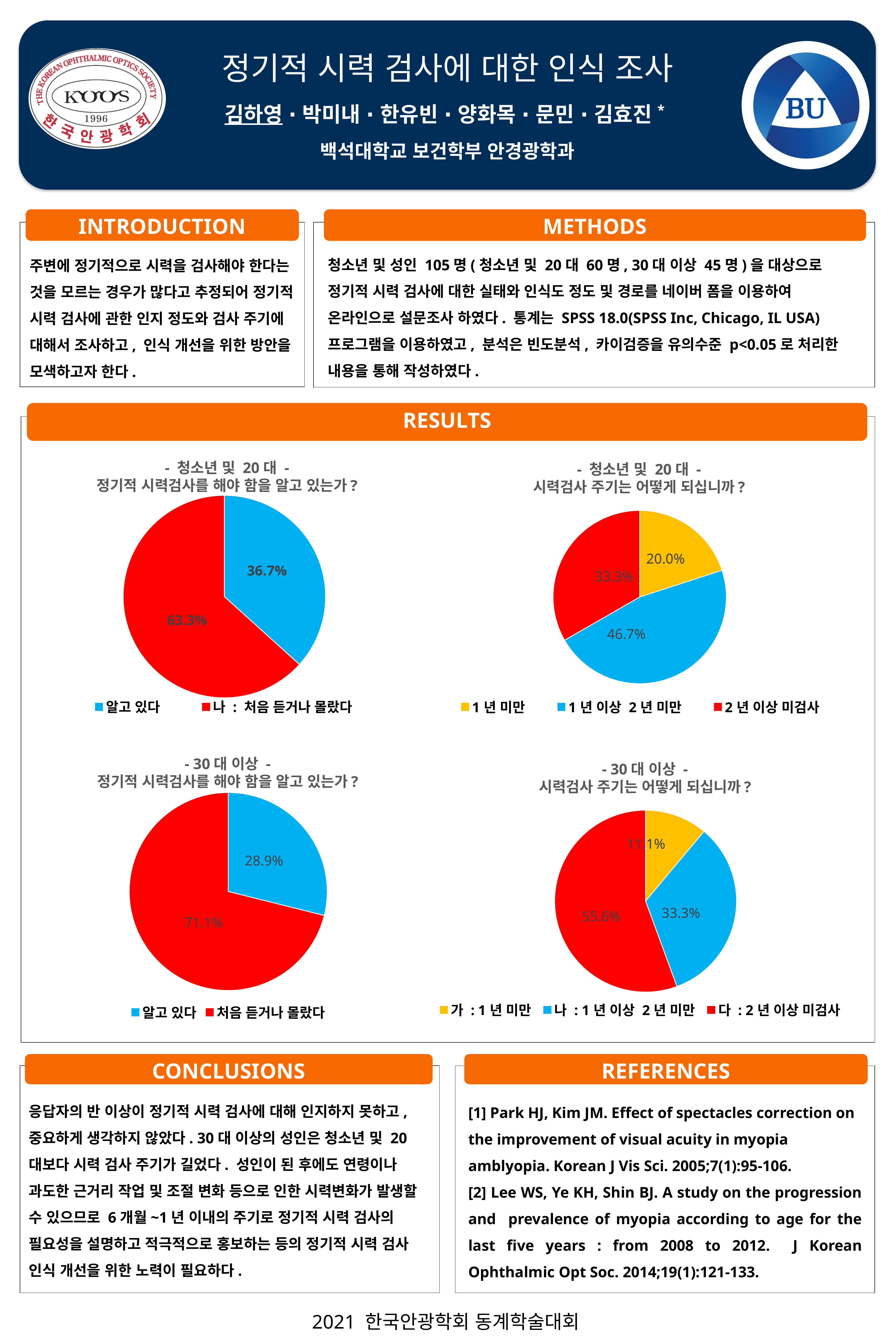
In the bottom-left pie chart (30대 이상, 정기적 시력검사를 해야 함을 알고 있는가?), what is the difference between 처음 듣거나 몰랐다 and 알고 있다? 42.2% Which is larger: the 알고 있다 share in the top-left pie chart (청소년 및 20대) or the 알고 있다 share in the bottom-left pie chart (30대 이상)? Top-left (청소년 및 20대), 36.7% In the top-right pie chart (청소년 및 20대, 시력검사 주기는 어떻게 되십니까?), how many categories does the legend list? 3 In the top-left pie chart (청소년 및 20대, 정기적 시력검사를 해야 함을 알고 있는가?), what percentage is shown for 나: 처음 듣거나 몰랐다? 63.3% In the top-right pie chart (청소년 및 20대, 시력검사 주기는 어떻게 되십니까?), what percentage is shown for 1년 이상 2년 미만? 46.7% What type of chart is used for the four charts in the RESULTS section? Pie chart In the top-left pie chart (청소년 및 20대, 정기적 시력검사를 해야 함을 알고 있는가?), what percentage is shown for 알고 있다? 36.7% In the bottom-right pie chart (30대 이상, 시력검사 주기는 어떻게 되십니까?), which category has the largest share? 다: 2년 이상 미검사 In the top-right pie chart (청소년 및 20대, 시력검사 주기는 어떻게 되십니까?), which category has the smallest share? 1년 미만 In the bottom-left pie chart (30대 이상, 정기적 시력검사를 해야 함을 알고 있는가?), what percentage is shown for 알고 있다? 28.9% In the bottom-right pie chart (30대 이상, 시력검사 주기는 어떻게 되십니까?), what percentage is shown for 가: 1년 미만? 11.1% In the bottom-right pie chart (30대 이상, 시력검사 주기는 어떻게 되십니까?), what percentage is shown for 다: 2년 이상 미검사? 55.6%